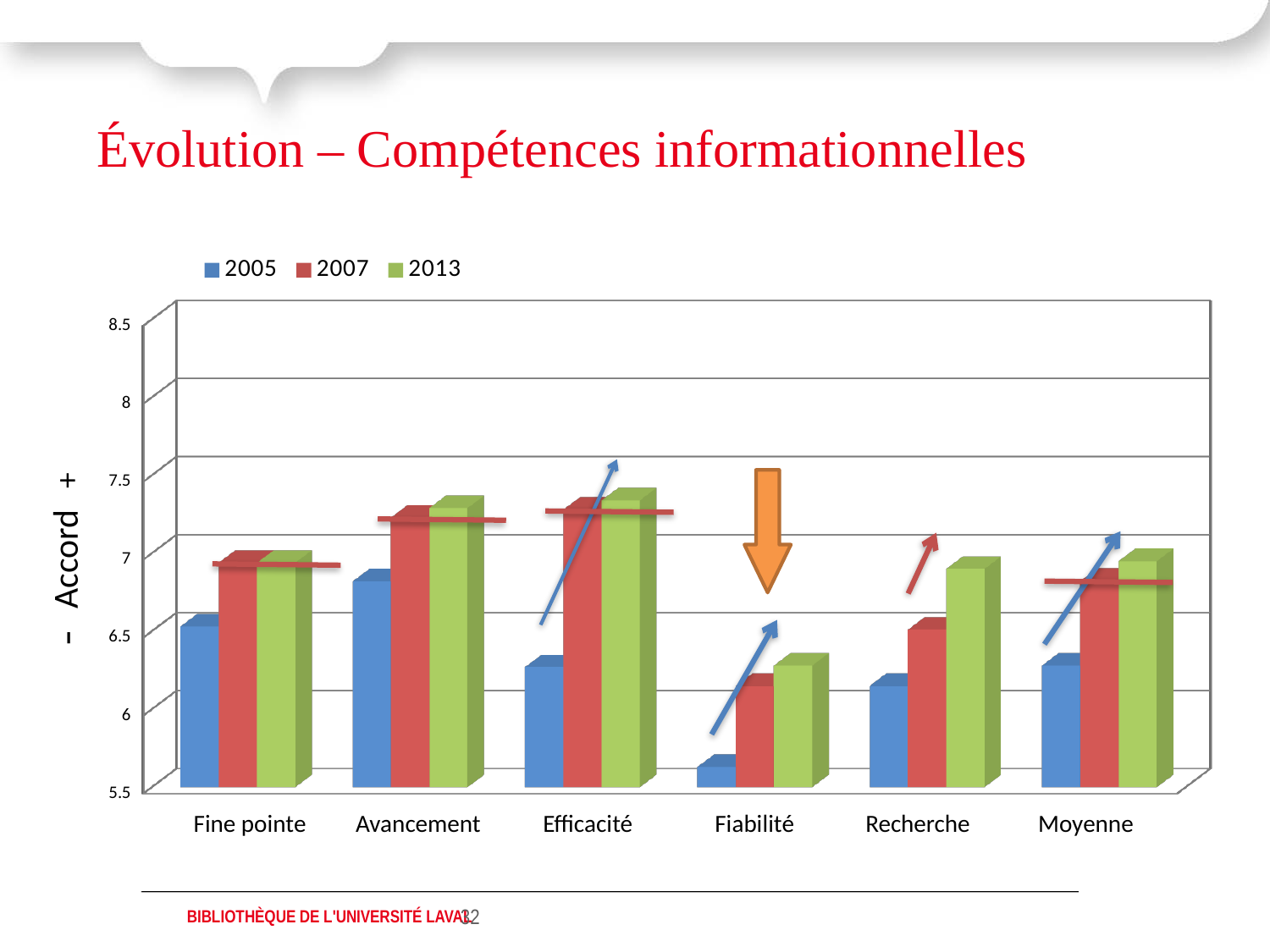
Which series are listed in the chart legend? 2005, 2007, 2013 Is the 2005 value for Efficacité greater or less than 6.5? less How many series does the chart legend list? 3 How many categories are shown on the x axis of the chart? 6 Which category has the highest value for the 2005 series? Avancement For the Recherche category, do the values rise or fall from 2005 to 2013? rise What kind of chart is shown on the slide? bar chart Which is larger, the 2013 value for Recherche or the 2013 value for Fiabilité? Recherche Which category has the lowest value for the 2005 series? Fiabilité Which category has the lowest value for the 2013 series? Fiabilité Is the 2013 value for Avancement greater or less than 7? greater Is the 2005 value for Fiabilité greater or less than 6? less